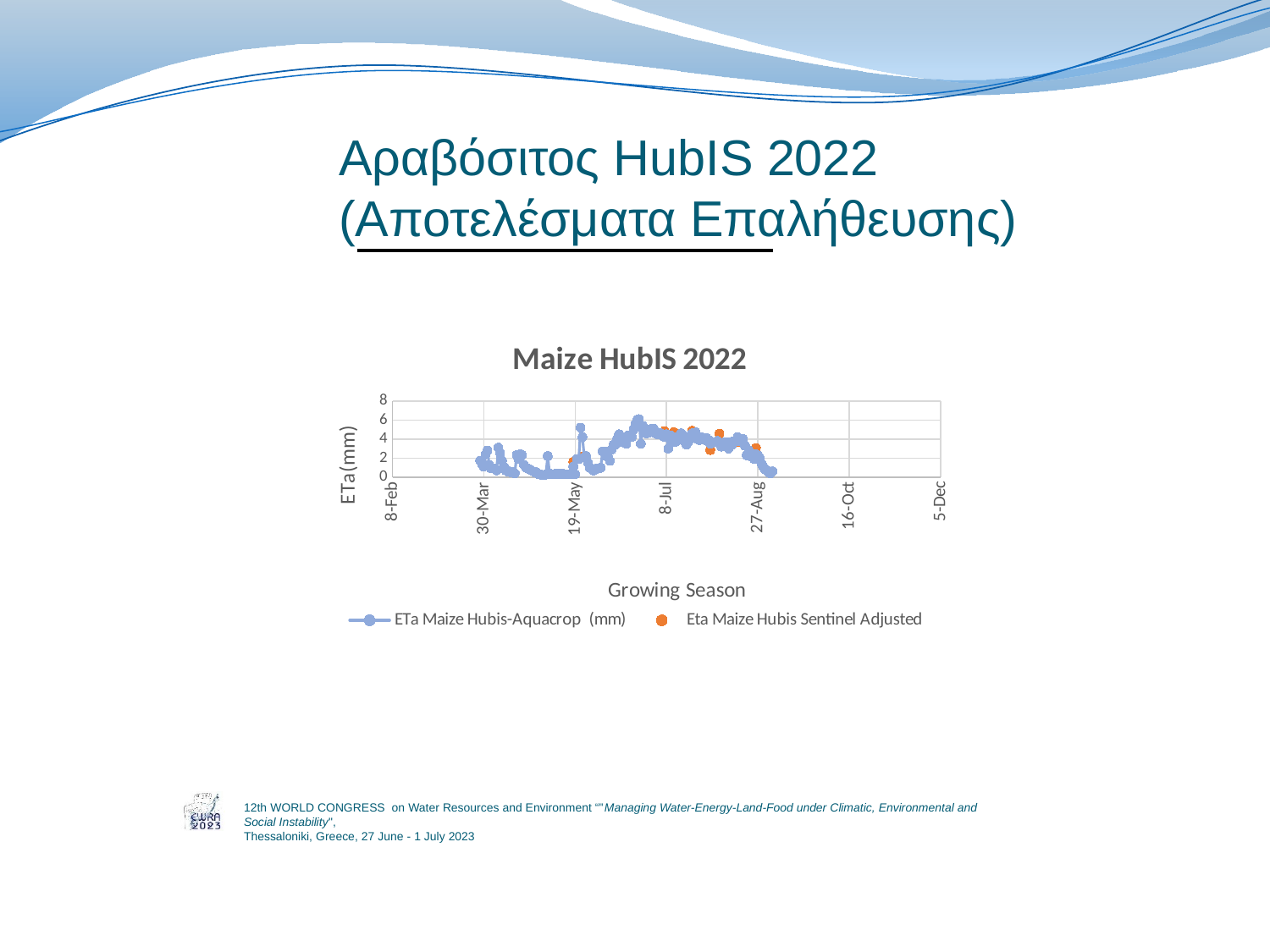
How many date labels are shown on the x axis? 7 What is the label of the y axis? ETa(mm) Is the peak value of the ETa Maize Hubis-Aquacrop (mm) series greater or less than 4? greater How many series does the chart legend list? 2 What is the last date label on the x axis? 5-Dec What is the title of the chart? Maize HubIS 2022 Which series is plotted with orange markers? Eta Maize Hubis Sentinel Adjusted What is the first date label on the x axis? 8-Feb Is the peak value of the ETa Maize Hubis-Aquacrop (mm) series greater or less than 8? less What is the highest value shown on the y axis? 8 Do the ETa Maize Hubis-Aquacrop (mm) values rise or fall between 8-Jul and 27-Aug? fall What kind of chart is shown on the slide? Line/scatter chart